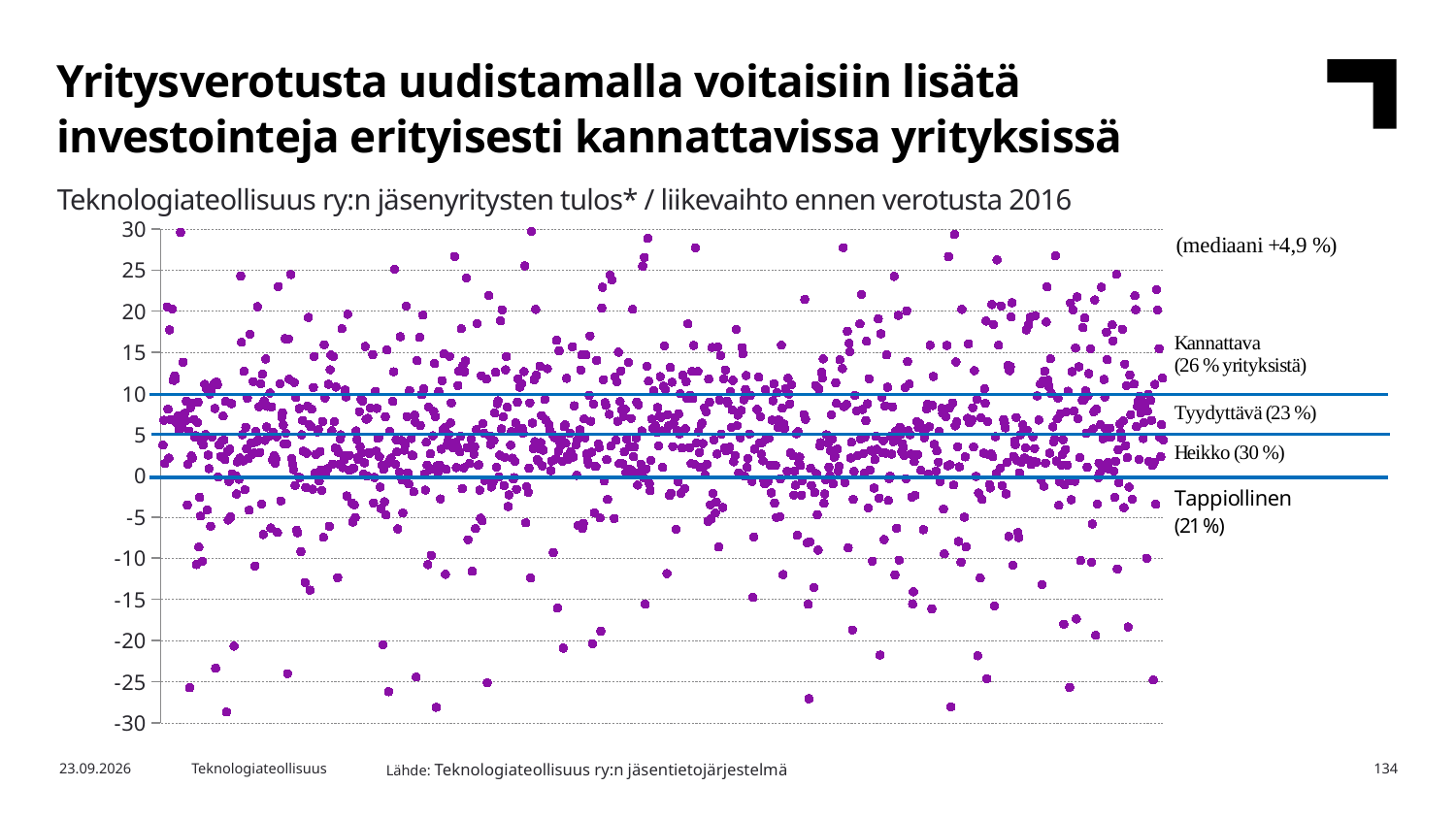
What kind of chart is shown on the slide? Scatter chart Which profitability category contains the smallest share of companies? Tappiollinen What is the median value of tulos / liikevaihto given on the chart? +4,9 % Which category has a larger share of companies, Kannattava or Tyydyttävä? Kannattava What is the highest value shown on the vertical axis? 30 What share of companies are in the Heikko category? 30 % What is the subtitle of the chart? Teknologiateollisuus ry:n jäsenyritysten tulos* / liikevaihto ennen verotusta 2016 What share of companies are in the Tappiollinen category? 21 % What share of companies are in the Kannattava category? 26 % What is the difference in percentage points between the share of companies in Heikko and in Tappiollinen? 9 What share of companies are in the Tyydyttävä category? 23 % Which profitability category contains the largest share of companies? Heikko